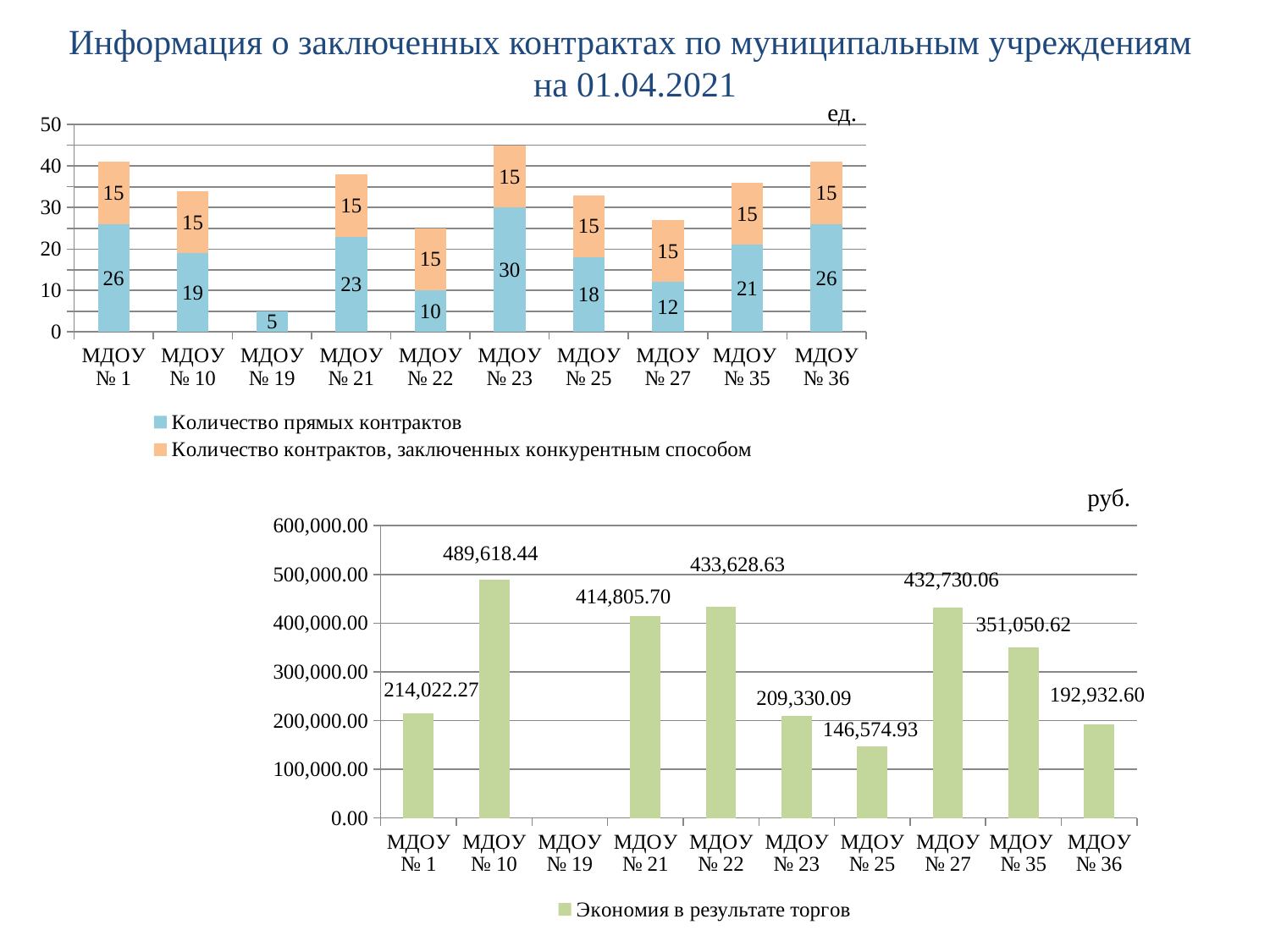
In the bottom chart, is the value for МДОУ № 35 greater or less than 300,000.00? greater In the top chart, how many direct contracts (Количество прямых контрактов) does МДОУ № 23 have? 30 In the bottom chart, what is the value for МДОУ № 10? 489,618.44 In the top chart, which institution has the highest number of direct contracts? МДОУ № 23 In the bottom chart, which institution has the lowest savings (Экономия в результате торгов)? МДОУ № 25 In the top chart, which institution has the lowest number of direct contracts? МДОУ № 19 In the top chart, what is the total height of the stacked bar for МДОУ № 1? 41 In the bottom chart, what is the difference between the values for МДОУ № 1 and МДОУ № 36? 21,089.67 In the top chart, what is the difference in direct contracts between МДОУ № 21 and МДОУ № 22? 13 What type of chart is the top chart? Stacked bar chart In the bottom chart, which is larger: the value for МДОУ № 22 or МДОУ № 27? МДОУ № 22 How many series does the legend of the top chart list? 2